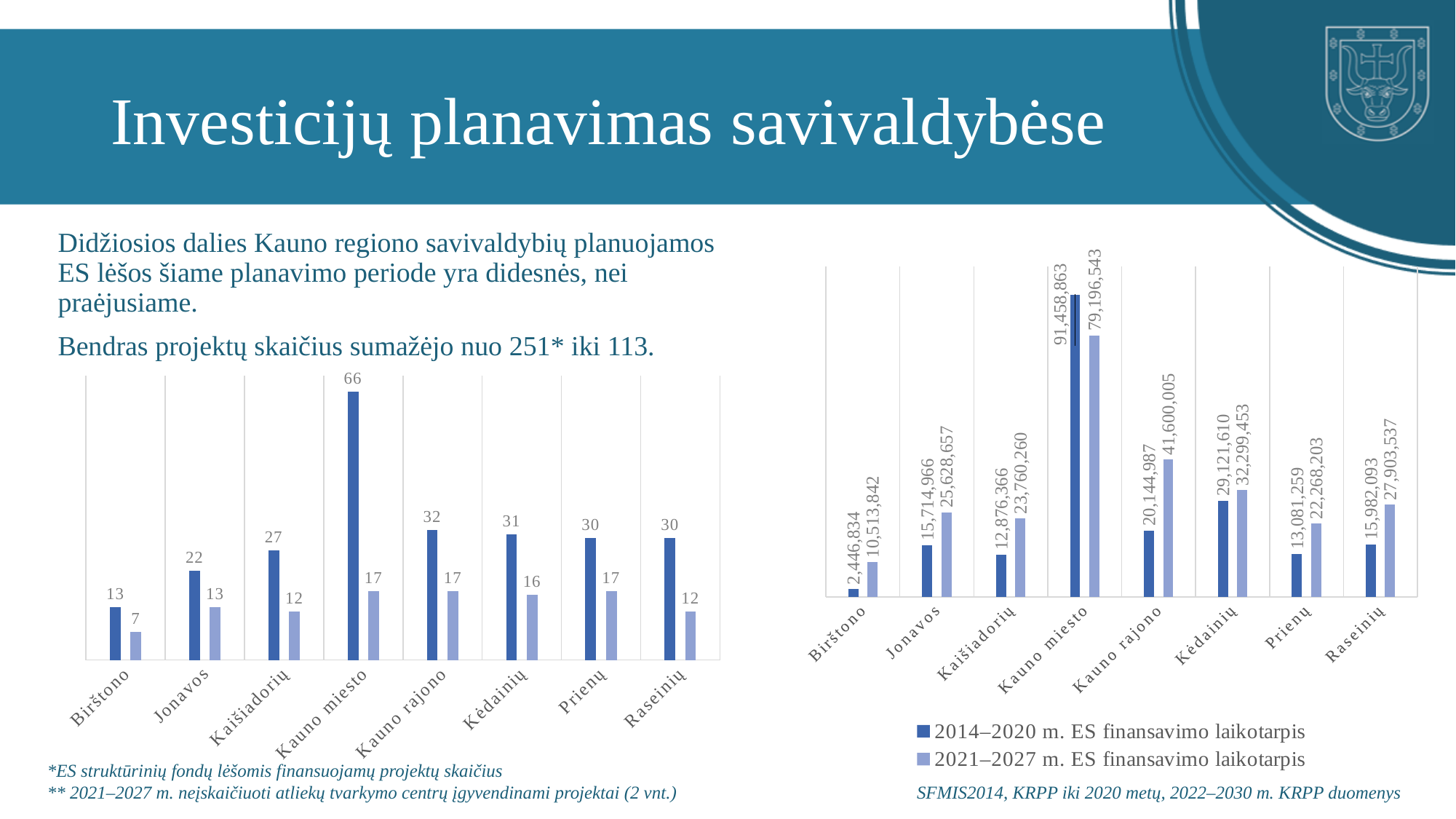
In the right chart, what is the 2014–2020 value for Birštono? 2,446,834 In the right chart, which is larger for Kauno miesto: the 2014–2020 value or the 2021–2027 value? 2014–2020 value In the left chart, what is the difference between the 2014–2020 and 2021–2027 values for Kauno miesto? 49 In the left chart, what is the value of the dark blue (2014–2020) bar for Kauno miesto? 66 How many categories are shown on the x axis of the left chart? 8 What type of chart is the right chart? Bar chart In the right chart, which category has the highest 2014–2020 bar? Kauno miesto In the right chart, what is the 2021–2027 value for Kauno rajono? 41,600,005 In the left chart, which category has the lowest light blue (2021–2027) bar? Birštono How many series does the legend on the slide list? 2 In the left chart, what is the value of the light blue (2021–2027) bar for Birštono? 7 In the left chart, which category has the highest dark blue (2014–2020) bar? Kauno miesto